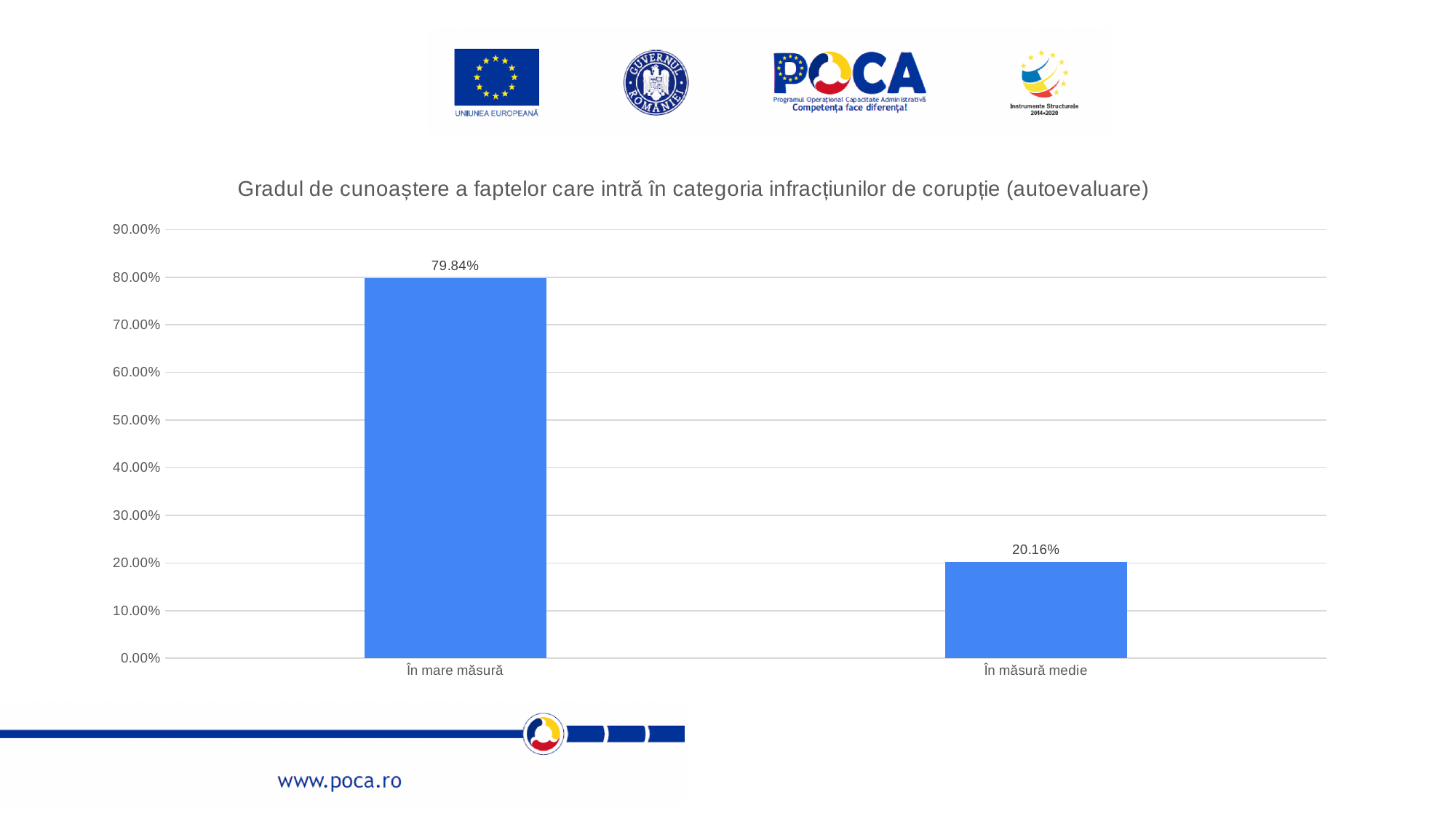
What is the value for "În măsură medie"? 20.16% Which category has the lowest value? În măsură medie Is the value for "În măsură medie" greater or less than 30.00%? less What is the value for "În mare măsură"? 79.84% Which is larger, the value for "În mare măsură" or the value for "În măsură medie"? În mare măsură Which category has the highest value? În mare măsură What is the title of the chart? Gradul de cunoaștere a faptelor care intră în categoria infracțiunilor de corupție (autoevaluare) What is the total of the two values shown on the chart? 100.00% What is the difference between the values for "În mare măsură" and "În măsură medie"? 59.68% Is the value for "În mare măsură" greater or less than 70.00%? greater What kind of chart is shown on the slide? bar chart How many categories are shown on the chart? 2